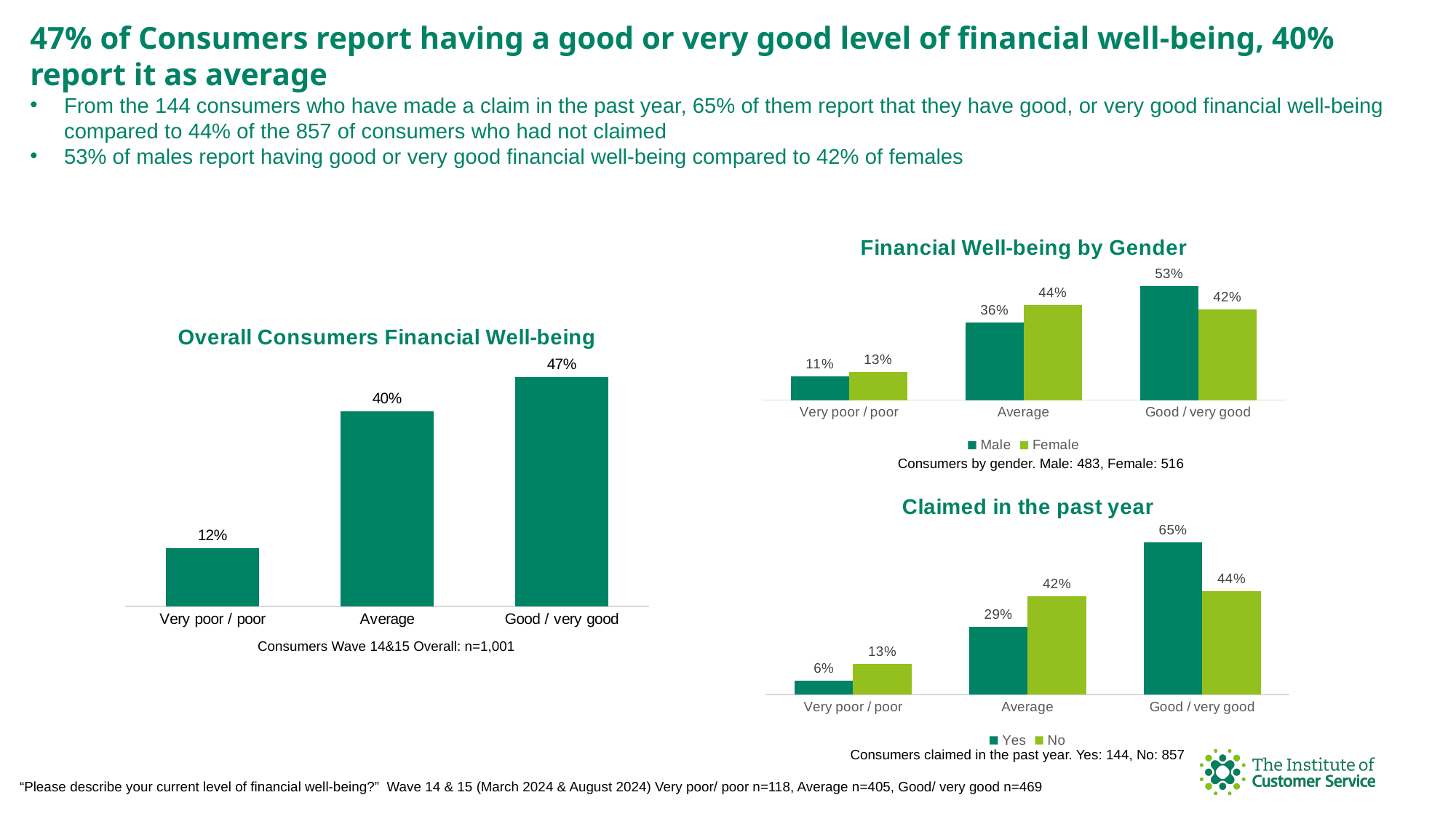
In the 'Claimed in the past year' chart, what is the Yes value for Very poor / poor? 6% How many series does the legend of the 'Financial Well-being by Gender' chart list? 2 What type of chart is the 'Claimed in the past year' chart? Bar chart In the 'Overall Consumers Financial Well-being' chart, what is the difference between Good / very good and Very poor / poor? 35% In the 'Financial Well-being by Gender' chart, what is the Female value for Average? 44% In the 'Claimed in the past year' chart, what is the difference between Yes and No for Good / very good? 21% In the 'Financial Well-being by Gender' chart, which is larger for Very poor / poor: Male or Female? Female In the 'Overall Consumers Financial Well-being' chart, which category has the lowest value? Very poor / poor In the 'Financial Well-being by Gender' chart, what is the Male value for Good / very good? 53% In the 'Claimed in the past year' chart, which category has the highest Yes value? Good / very good In the 'Overall Consumers Financial Well-being' chart, what is the value for Average? 40% In the 'Overall Consumers Financial Well-being' chart, how many categories are shown? 3